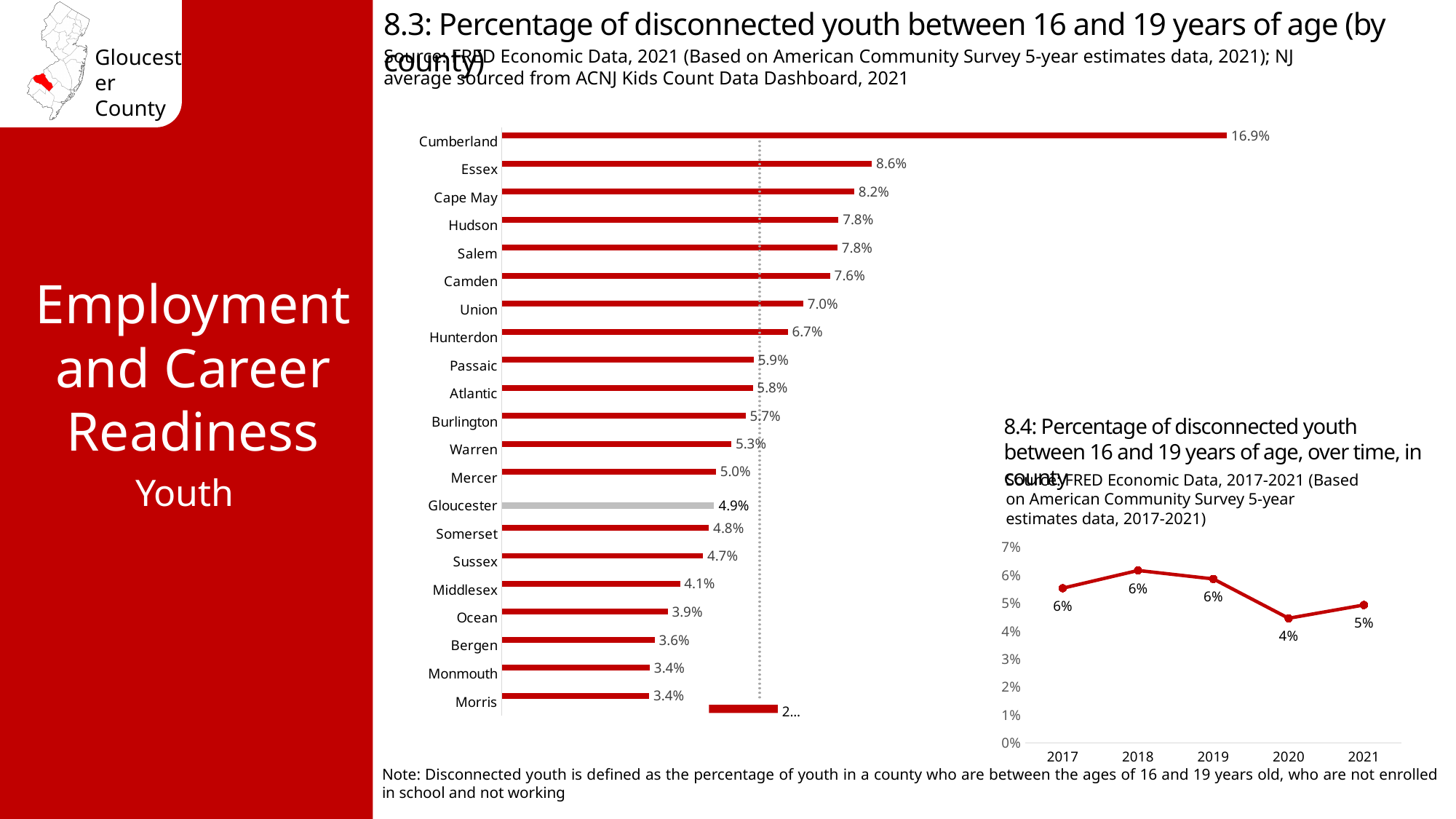
In the chart 8.3 (percentage of disconnected youth by county), which county has the highest value? Cumberland In the chart 8.3 (percentage of disconnected youth by county), what is the value for Middlesex? 4.1% In the chart 8.3 (percentage of disconnected youth by county), how many counties are listed? 21 In the chart 8.4 (percentage of disconnected youth over time), is the value for 2020 greater or less than 5%? less In the chart 8.3 (percentage of disconnected youth by county), what is the value for Gloucester? 4.9% In the chart 8.4 (percentage of disconnected youth over time), which year has the lowest value? 2020 What kind of chart is chart 8.3 (percentage of disconnected youth by county)? Bar chart In the chart 8.3 (percentage of disconnected youth by county), which is larger, the value for Camden or the value for Union? Camden In the chart 8.3 (percentage of disconnected youth by county), what is the value for Cumberland? 16.9% In the chart 8.4 (percentage of disconnected youth over time), how many years are plotted? 5 In the chart 8.3 (percentage of disconnected youth by county), what is the difference between the values for Cumberland and Essex? 8.3 percentage points In the chart 8.4 (percentage of disconnected youth over time), what is the value for 2020? 4%